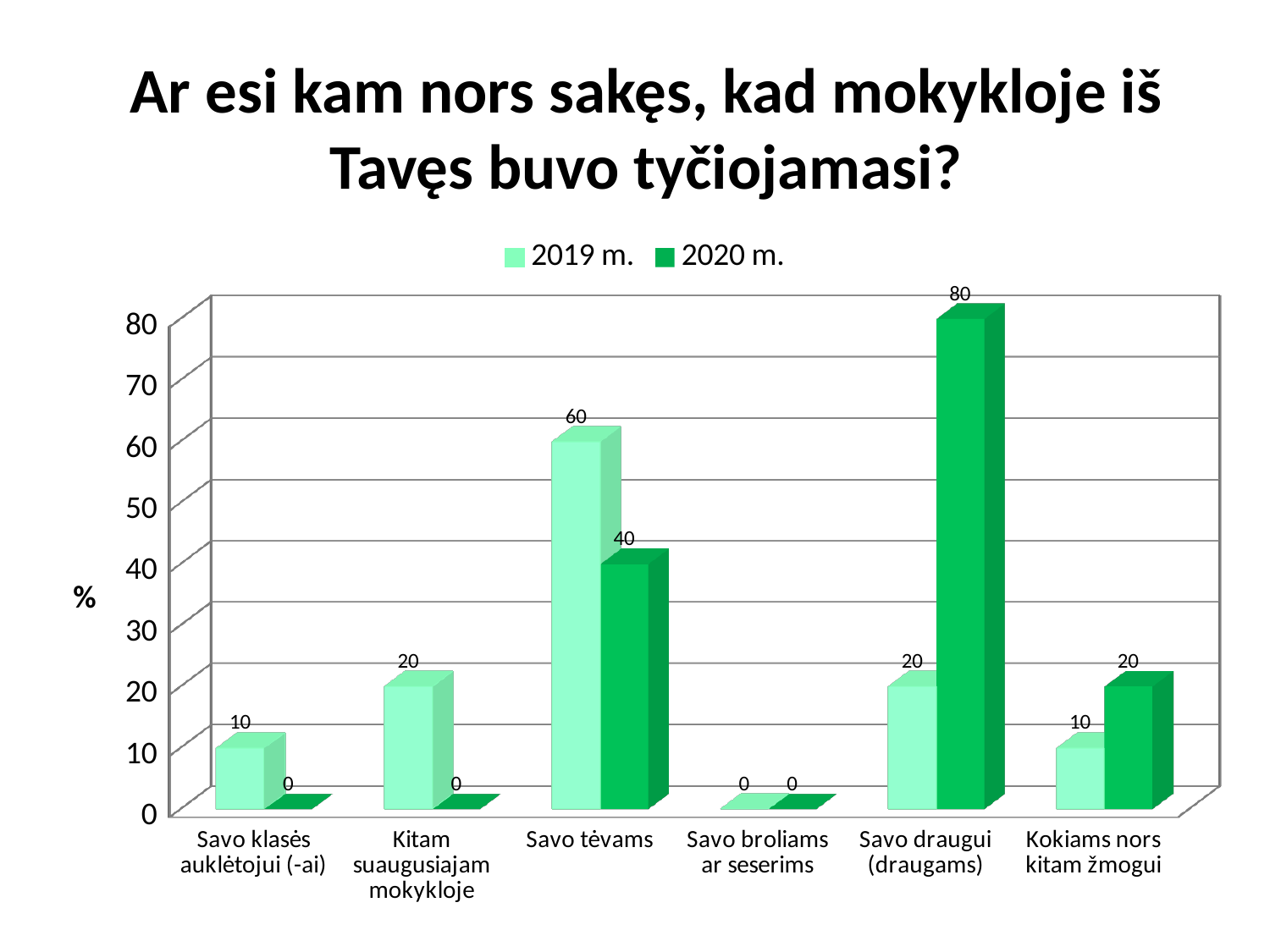
How many categories are shown on the x axis? 6 What label is shown on the vertical axis? % Which category has the highest value in the 2020 m. series? Savo draugui (draugams) What is the value for 'Savo draugui (draugams)' in the 2020 m. series? 80 What kind of chart is shown on the slide? Bar chart Which is larger for 'Kokiams nors kitam žmogui': the 2019 m. value or the 2020 m. value? 2020 m. How many series does the legend list? 2 Which category has the highest value in the 2019 m. series? Savo tėvams What is the value for 'Kitam suaugusiajam mokykloje' in the 2020 m. series? 0 What is the value for 'Savo tėvams' in the 2019 m. series? 60 What is the difference between the 2020 m. value for 'Savo draugui (draugams)' and the 2019 m. value for the same category? 60 What is the difference between the 2019 m. and 2020 m. values for 'Savo tėvams'? 20